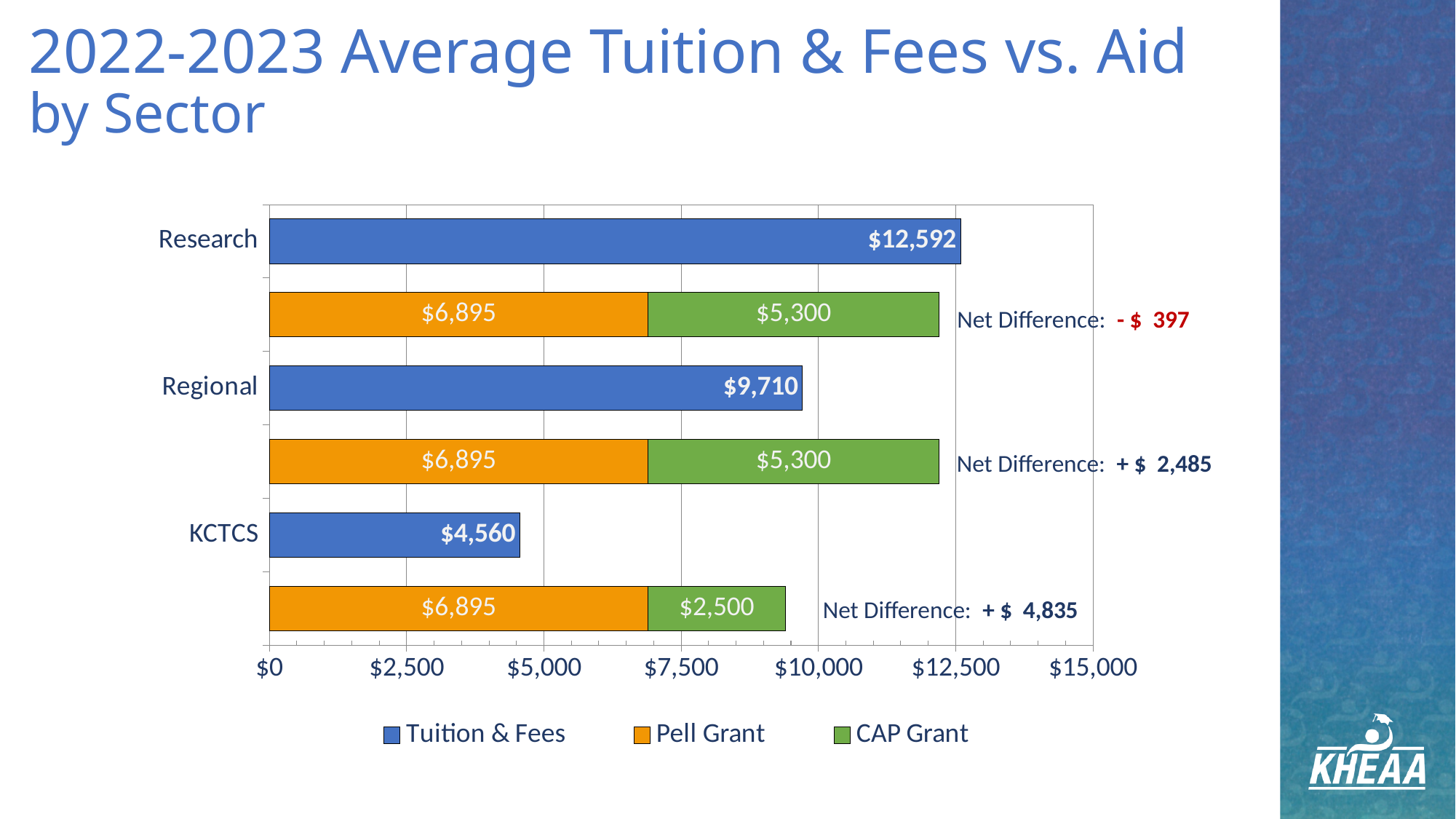
What is the total of the Pell Grant and CAP Grant bar for the Research sector? $12,195 What is the Pell Grant value for the Regional sector? $6,895 What is the CAP Grant value for KCTCS? $2,500 Which sector has the highest Tuition & Fees? Research What is the Tuition & Fees value for KCTCS? $4,560 Which is larger: Tuition & Fees for KCTCS or the Pell Grant for KCTCS? Pell Grant for KCTCS What is the Tuition & Fees value for the Research sector? $12,592 What kind of chart is shown on the slide? Bar chart What is the difference between Tuition & Fees for Research and Regional? $2,882 Is the Tuition & Fees value for Regional greater or less than $10,000? less How many series does the legend list? 3 Which sector has the lowest Tuition & Fees? KCTCS